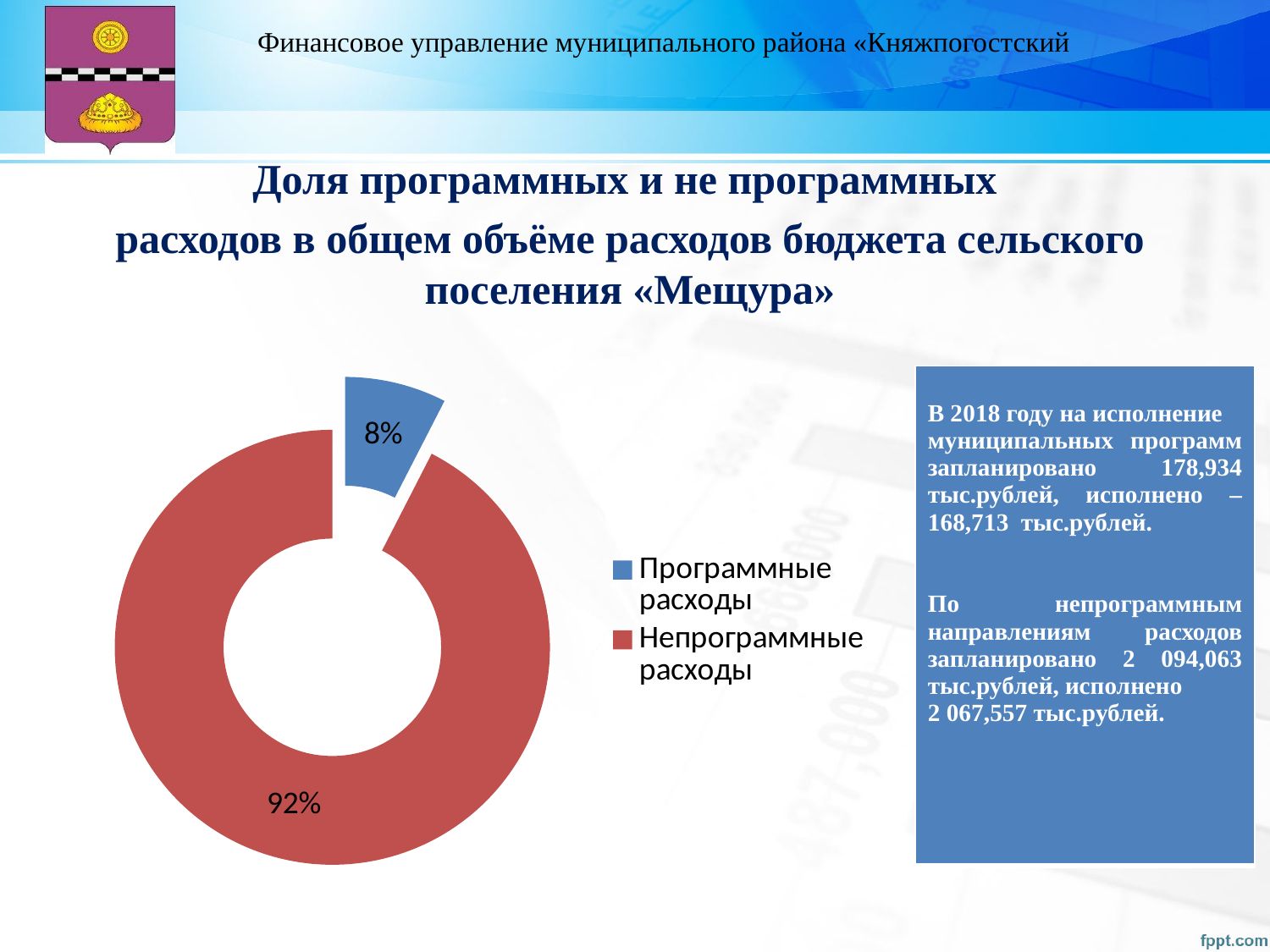
What kind of chart is shown on the slide? Pie chart (doughnut) What share of the pie does Программные расходы represent? 8% How many entries does the legend list? 2 Which is larger: the share for Программные расходы or the share for Непрограммные расходы? Непрограммные расходы What share of the pie does Непрограммные расходы represent? 92% What is the difference in percentage points between Непрограммные расходы and Программные расходы? 84 Which category has the smallest share of the pie? Программные расходы What colour is the slice for Программные расходы? Blue What colour is the slice for Непрограммные расходы? Red How many categories are shown in the pie chart? 2 Which category has the largest share of the pie? Непрограммные расходы